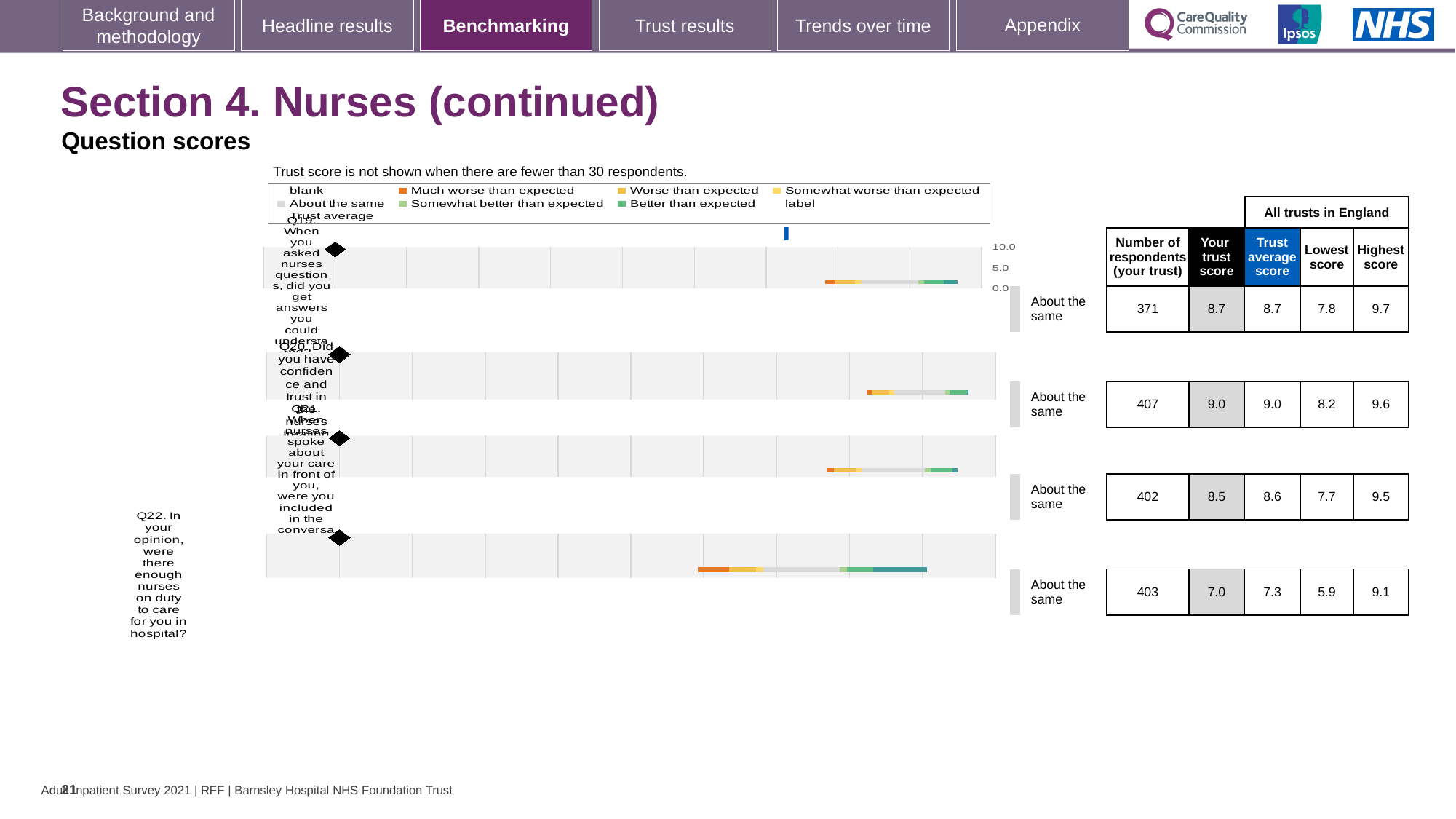
What kind of chart is used to show the question scores on this slide? bar chart What benchmark category is shown for all four questions on this slide? About the same Which question has the highest 'Your trust score'? Q20 What is the trust average score for Q20 (confidence and trust in nurses)? 9.0 What is the difference between the highest score and the lowest score for Q22? 3.2 How many questions (categories) are plotted in the chart? 4 How many respondents from your trust answered Q19? 371 Which question has the lowest 'Your trust score'? Q22 Which is larger, the 'Your trust score' for Q19 or for Q20? Q20 What is the 'Your trust score' for Q22 (enough nurses on duty)? 7.0 What is the lowest score across all trusts in England for Q21? 7.7